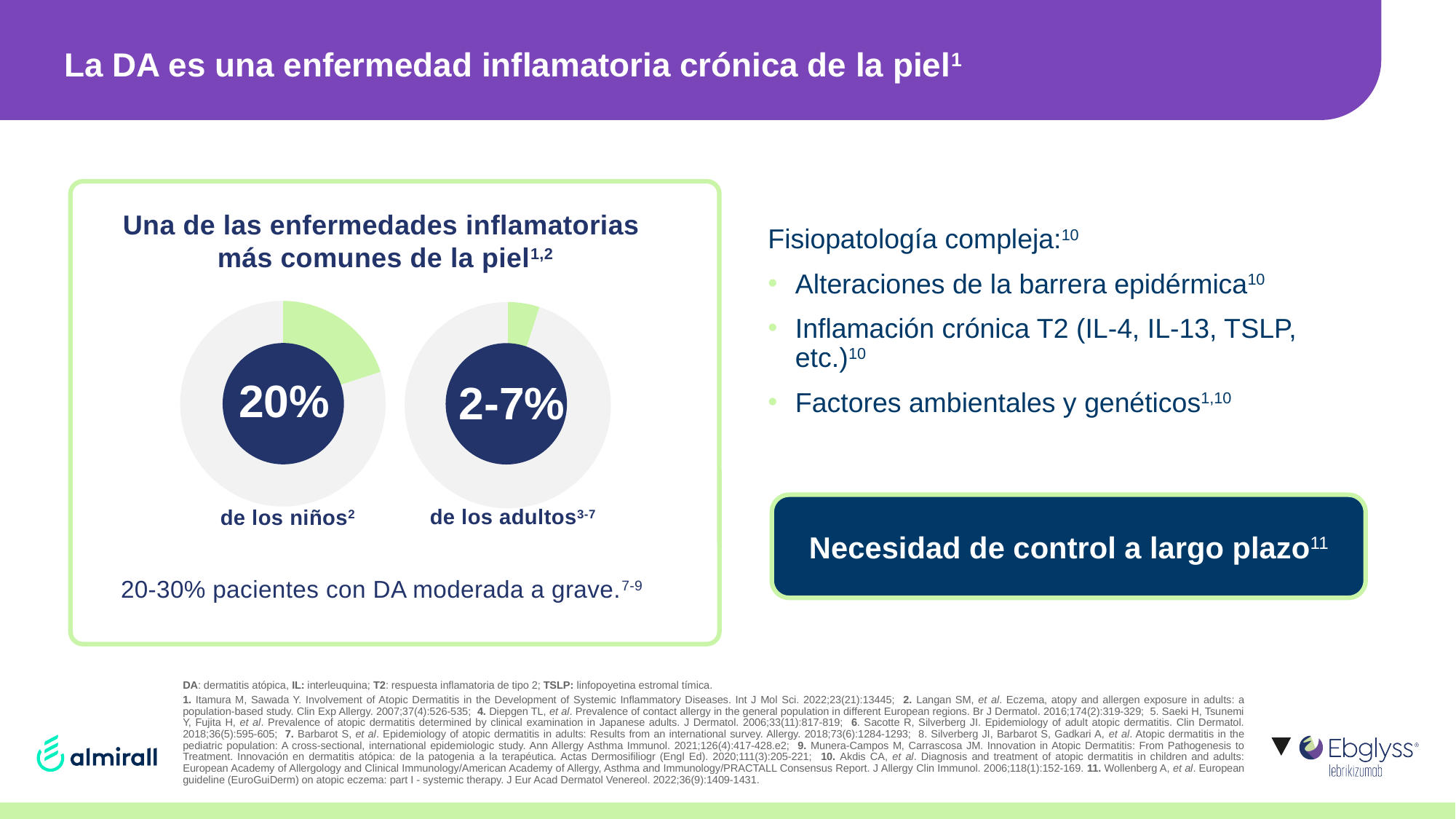
What value is shown in the centre of the right donut chart (de los adultos)? 2-7% Which donut chart shows the smaller highlighted share? de los adultos (2-7%) How many donut charts are shown on the slide? 2 What colour is the highlighted slice in both donut charts? Light green Which donut chart shows the larger highlighted share? de los niños (20%) What kind of chart is used to show the 20% and 2-7% figures? Donut (pie) chart What value is shown in the centre of the left donut chart (de los niños)? 20% Which group has the larger highlighted share, de los niños or de los adultos? de los niños What is the label under the left donut chart? de los niños